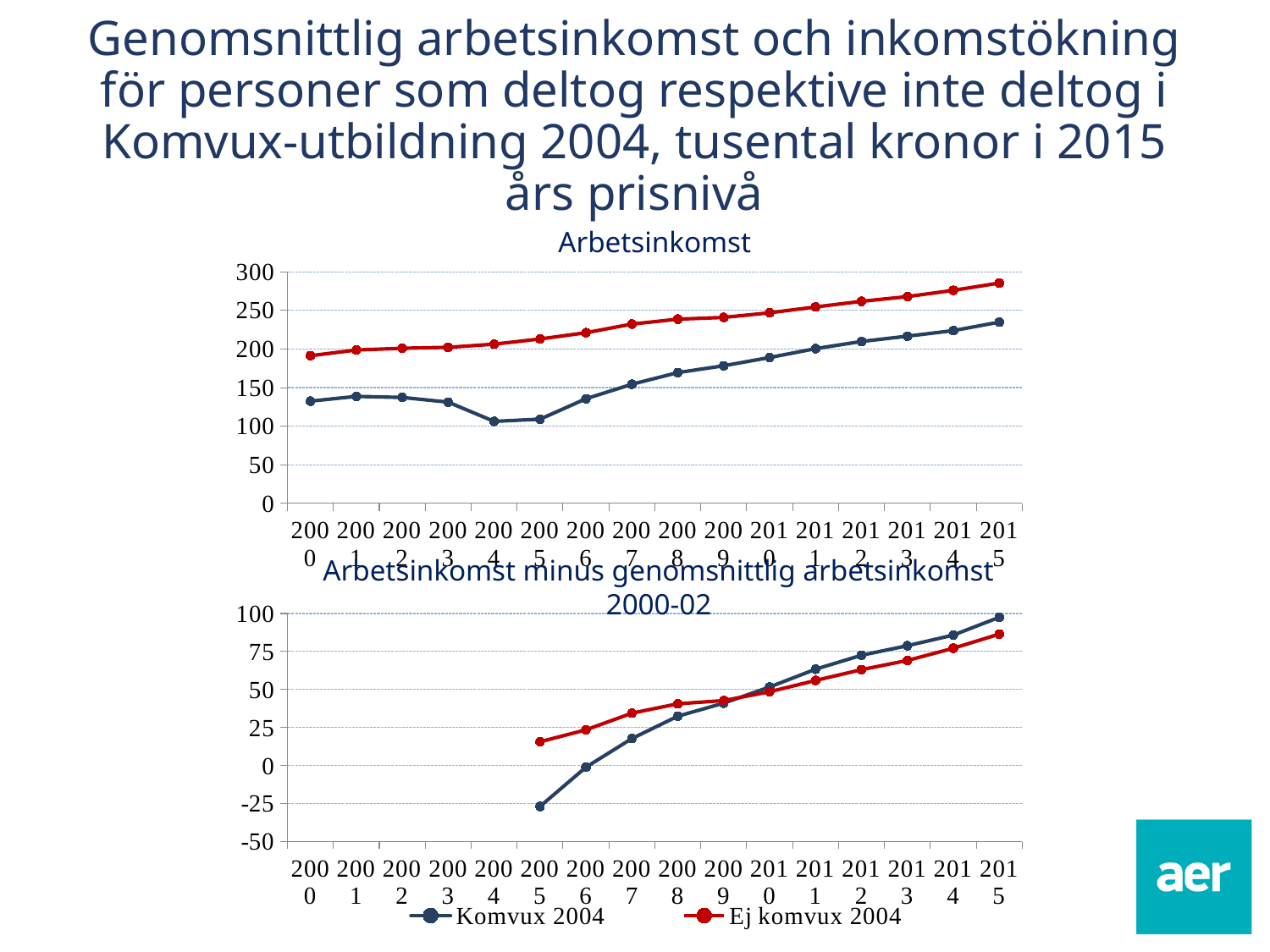
In the bottom chart "Arbetsinkomst minus genomsnittlig arbetsinkomst 2000-02", which series has the higher value in 2015, Komvux 2004 or Ej komvux 2004? Komvux 2004 In the bottom chart "Arbetsinkomst minus genomsnittlig arbetsinkomst 2000-02", in which year is the value for Komvux 2004 lowest? 2005 What kind of chart is the top chart titled "Arbetsinkomst"? line chart In the bottom chart "Arbetsinkomst minus genomsnittlig arbetsinkomst 2000-02", is the value for Komvux 2004 in 2005 greater or less than 0? less How many series does the legend list? 2 In the top chart "Arbetsinkomst", how many years are shown on the x axis? 16 What colour is the line for Ej komvux 2004? red In the top chart "Arbetsinkomst", is the value for Komvux 2004 in 2004 greater or less than 150? less In the top chart "Arbetsinkomst", which series has the higher value in 2010, Komvux 2004 or Ej komvux 2004? Ej komvux 2004 In the top chart "Arbetsinkomst", in which year is the value for Ej komvux 2004 highest? 2015 In the top chart "Arbetsinkomst", is the value for Ej komvux 2004 in 2015 greater or less than 250? greater In the top chart "Arbetsinkomst", does the value for Ej komvux 2004 rise or fall from 2000 to 2015? rise